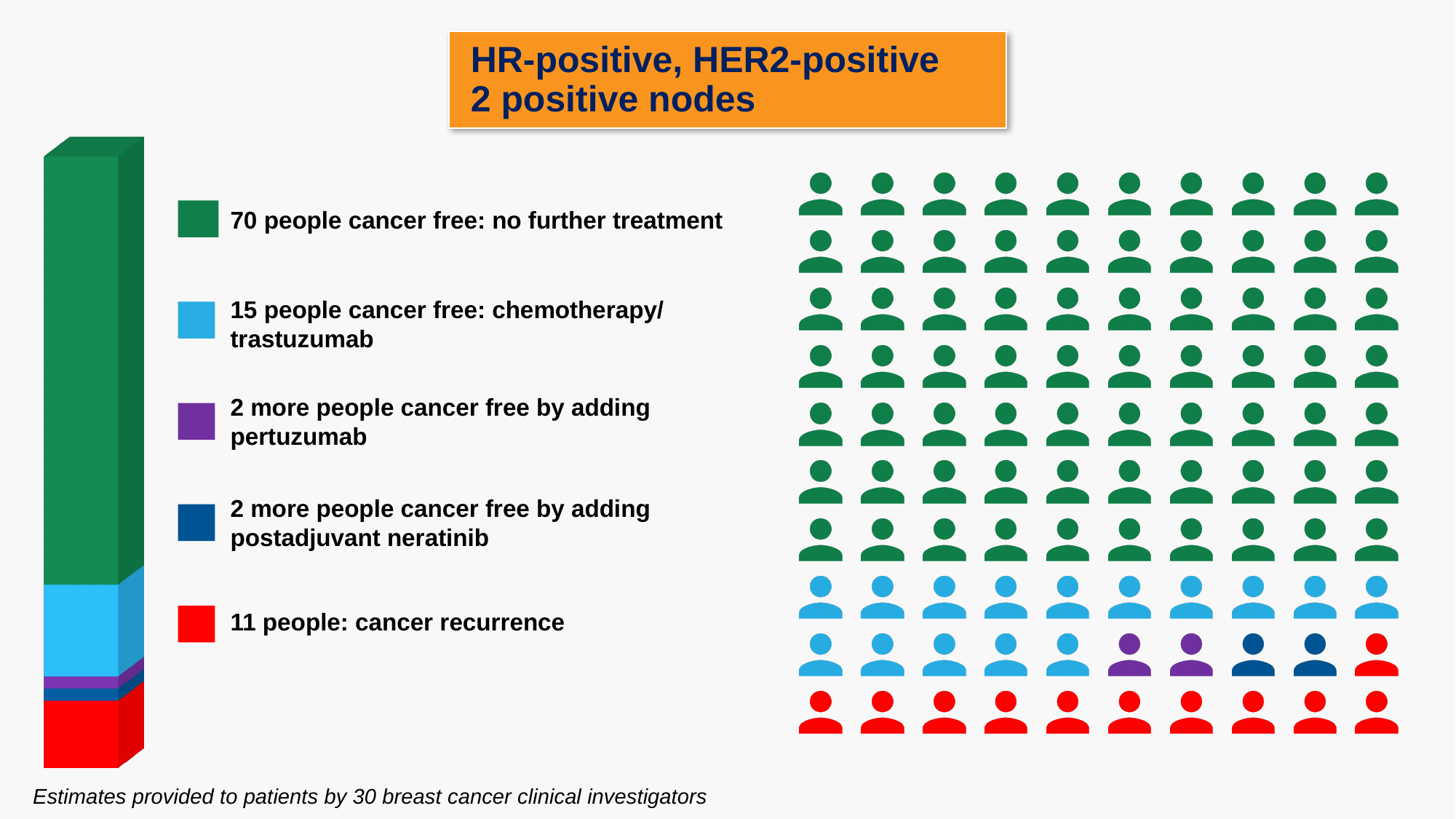
How many groups does the legend list? 5 What colour represents people with cancer recurrence? Red What is the difference between the number of people cancer free with no further treatment and the number with cancer recurrence? 59 What patient group is named in the slide title? HR-positive, HER2-positive, 2 positive nodes What is the total number of people represented in the stacked bar? 100 How many more people are cancer free by adding postadjuvant neratinib? 2 How many people are cancer free with chemotherapy/trastuzumab? 15 How many people have a cancer recurrence? 11 How many more people are cancer free by adding pertuzumab? 2 How many people are cancer free with no further treatment? 70 Which group has the largest number of people? Cancer free: no further treatment Which is larger: the number of people cancer free with chemotherapy/trastuzumab or the number with cancer recurrence? Cancer free: chemotherapy/trastuzumab